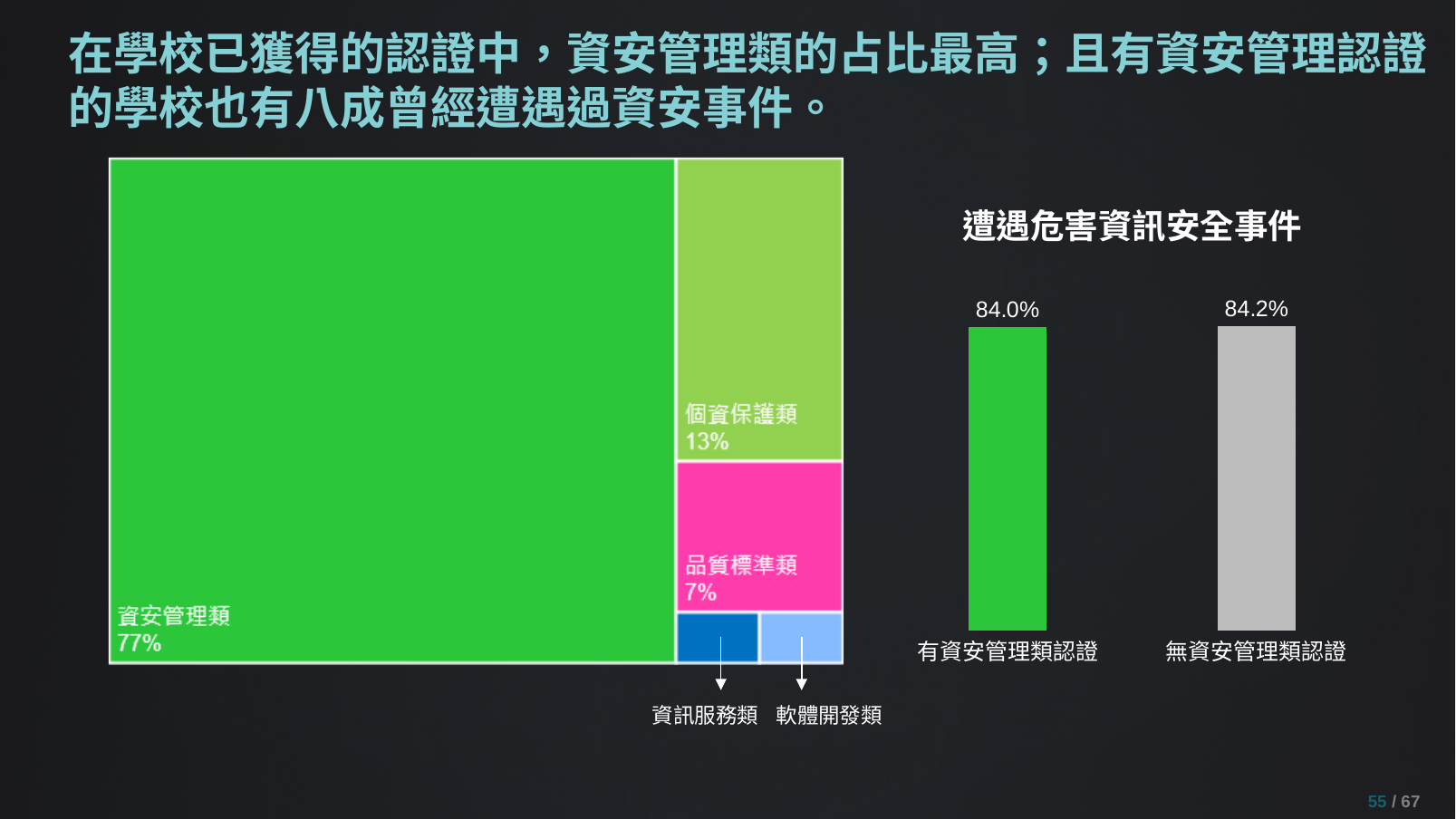
In the chart titled 遭遇危害資訊安全事件, how many bars are shown? 2 What kind of chart is the one titled 遭遇危害資訊安全事件? bar chart In the chart titled 遭遇危害資訊安全事件, what is the difference in percentage points between 無資安管理類認證 and 有資安管理類認證? 0.2 In the treemap on the left, what share does 品質標準類 account for? 7% In the chart titled 遭遇危害資訊安全事件, what is the value for 無資安管理類認證? 84.2% In the treemap on the left, how many categories are shown? 5 In the chart titled 遭遇危害資訊安全事件, what is the value for 有資安管理類認證? 84.0% In the treemap on the left, how many percentage points larger is 資安管理類 than 個資保護類? 64 In the treemap on the left, what share does 個資保護類 account for? 13% In the treemap on the left, which category has the largest share? 資安管理類 In the treemap on the left, what share does 資安管理類 account for? 77% In the treemap on the left, which is larger, 個資保護類 or 品質標準類? 個資保護類